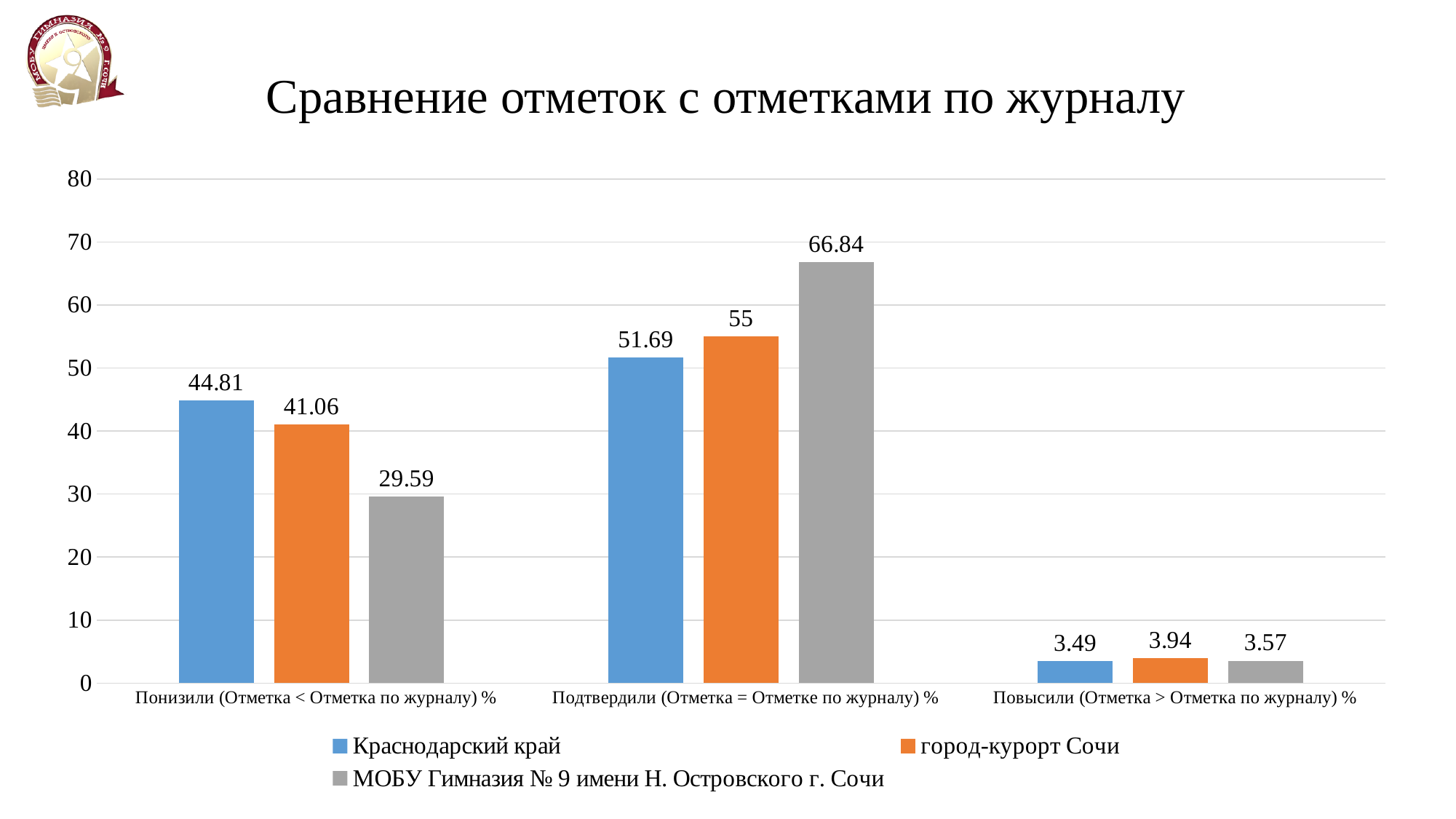
How many series does the legend list? 3 What is the title of the chart? Сравнение отметок с отметками по журналу How many categories are shown on the x axis? 3 What is the value for Краснодарский край in the Понизили (Отметка < Отметка по журналу) % category? 44.81 Which series has the highest value in the Подтвердили (Отметка = Отметке по журналу) % category? МОБУ Гимназия № 9 имени Н. Островского г. Сочи What is the value for город-курорт Сочи in the Повысили (Отметка > Отметка по журналу) % category? 3.94 Which is larger in the Подтвердили (Отметка = Отметке по журналу) % category: Краснодарский край or город-курорт Сочи? город-курорт Сочи What is the value for МОБУ Гимназия № 9 имени Н. Островского г. Сочи in the Подтвердили (Отметка = Отметке по журналу) % category? 66.84 What is the difference between the Краснодарский край and город-курорт Сочи values in the Понизили (Отметка < Отметка по журналу) % category? 3.75 Which series has the lowest value in the Понизили (Отметка < Отметка по журналу) % category? МОБУ Гимназия № 9 имени Н. Островского г. Сочи Is the value for МОБУ Гимназия № 9 имени Н. Островского г. Сочи in the Подтвердили category greater or less than 60? greater What kind of chart is shown on the slide? bar chart